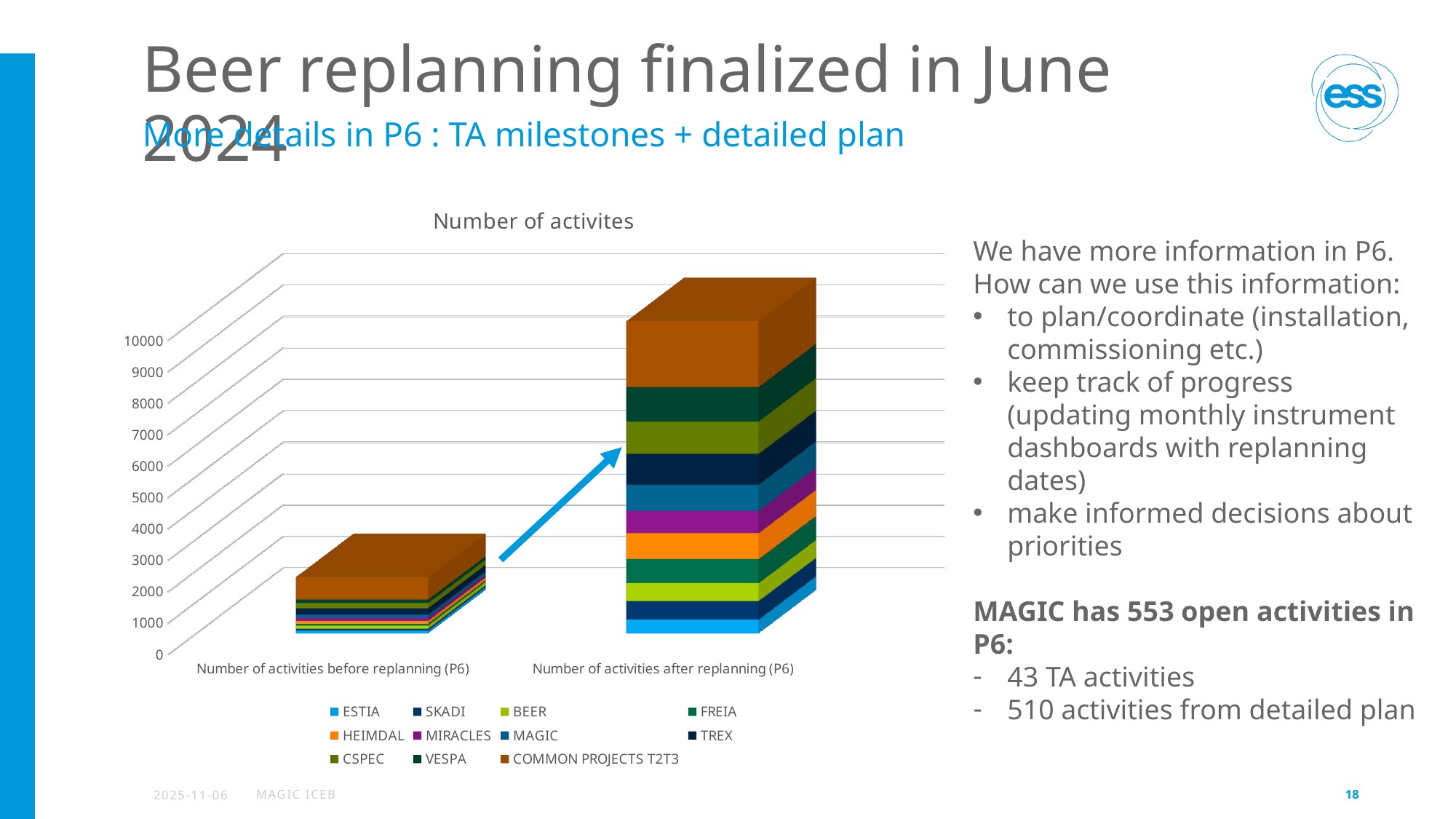
Which series is shown as the top segment of each stacked bar? COMMON PROJECTS T2T3 Which category has the highest total number of activities? Number of activities after replanning (P6) How many series does the chart's legend list? 11 Is the total for 'Number of activities before replanning (P6)' greater or less than 5000? less What kind of chart is shown on the slide? Stacked bar chart Which category has the lowest total number of activities? Number of activities before replanning (P6) Which category has the taller stacked bar, 'Number of activities before replanning (P6)' or 'Number of activities after replanning (P6)'? Number of activities after replanning (P6) Do the total number of activities rise or fall from the 'before replanning' category to the 'after replanning' category? rise How many categories are plotted on the x axis of the chart? 2 Is the total for 'Number of activities after replanning (P6)' greater or less than 5000? greater Is the total for 'Number of activities after replanning (P6)' greater or less than 8000? greater What is the title of the chart? Number of activites